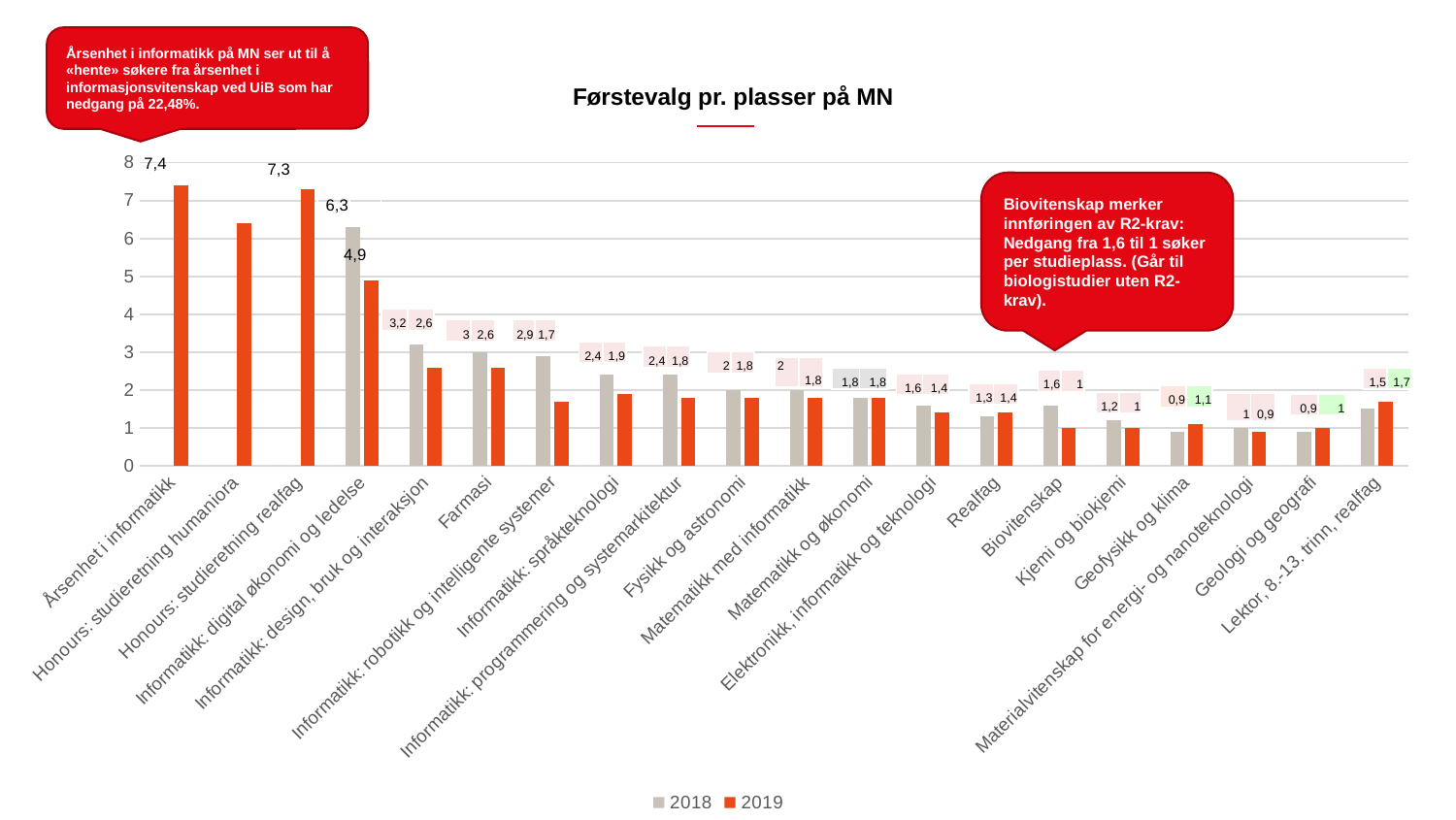
What is the title of the chart? Førstevalg pr. plasser på MN What is the 2018 value for Farmasi? 3 What is the 2019 value for Biovitenskap? 1 How many categories are shown on the x axis? 20 How many series does the legend list? 2 What is the difference between the 2018 and 2019 values for Informatikk: robotikk og intelligente systemer? 1,2 For Geofysikk og klima, which series has the larger value, 2018 or 2019? 2019 What is the 2019 value for Informatikk: digital økonomi og ledelse? 4,9 Is the 2019 value for Honours: studieretning humaniora greater or less than 6? greater What kind of chart is shown on the slide? bar chart What is the 2019 value for Lektor, 8.-13. trinn, realfag? 1,7 Which category has the highest 2019 value? Årsenhet i informatikk